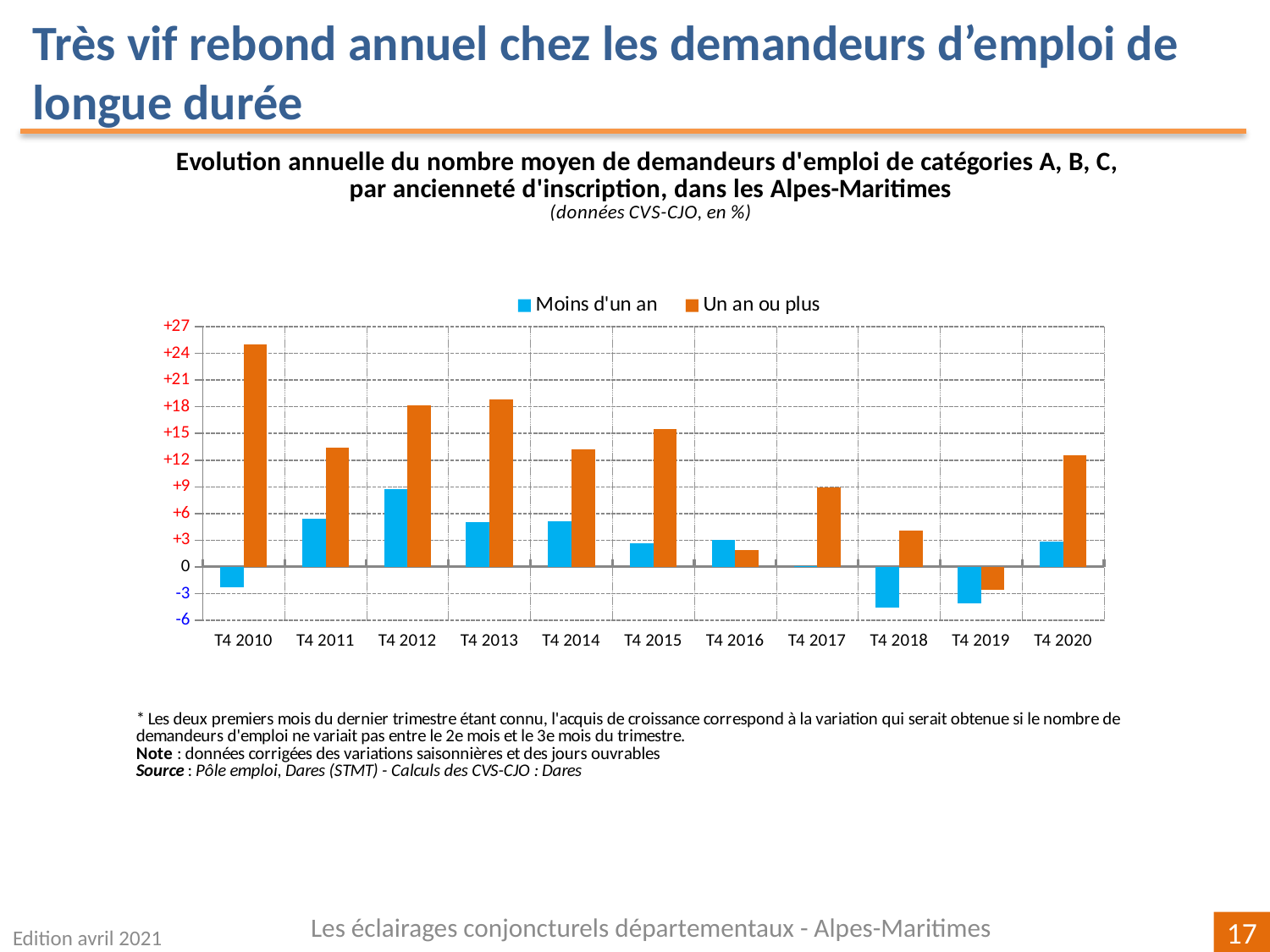
Is the value for 'Un an ou plus' in T4 2010 greater or less than +24? greater Is the value for 'Moins d'un an' in T4 2018 greater or less than -3? less Is the value for 'Un an ou plus' in T4 2020 greater or less than +9? greater Which quarter has the lowest value for 'Un an ou plus'? T4 2019 What kind of chart is shown on the slide? bar chart Which quarter has the highest value for 'Moins d'un an'? T4 2012 In T4 2016, which series has the larger value, 'Moins d'un an' or 'Un an ou plus'? Moins d'un an Which quarter has the highest value for 'Un an ou plus'? T4 2010 How many quarters (categories) are shown on the x axis? 11 Which series is shown in orange in the legend? Un an ou plus How many series does the legend list? 2